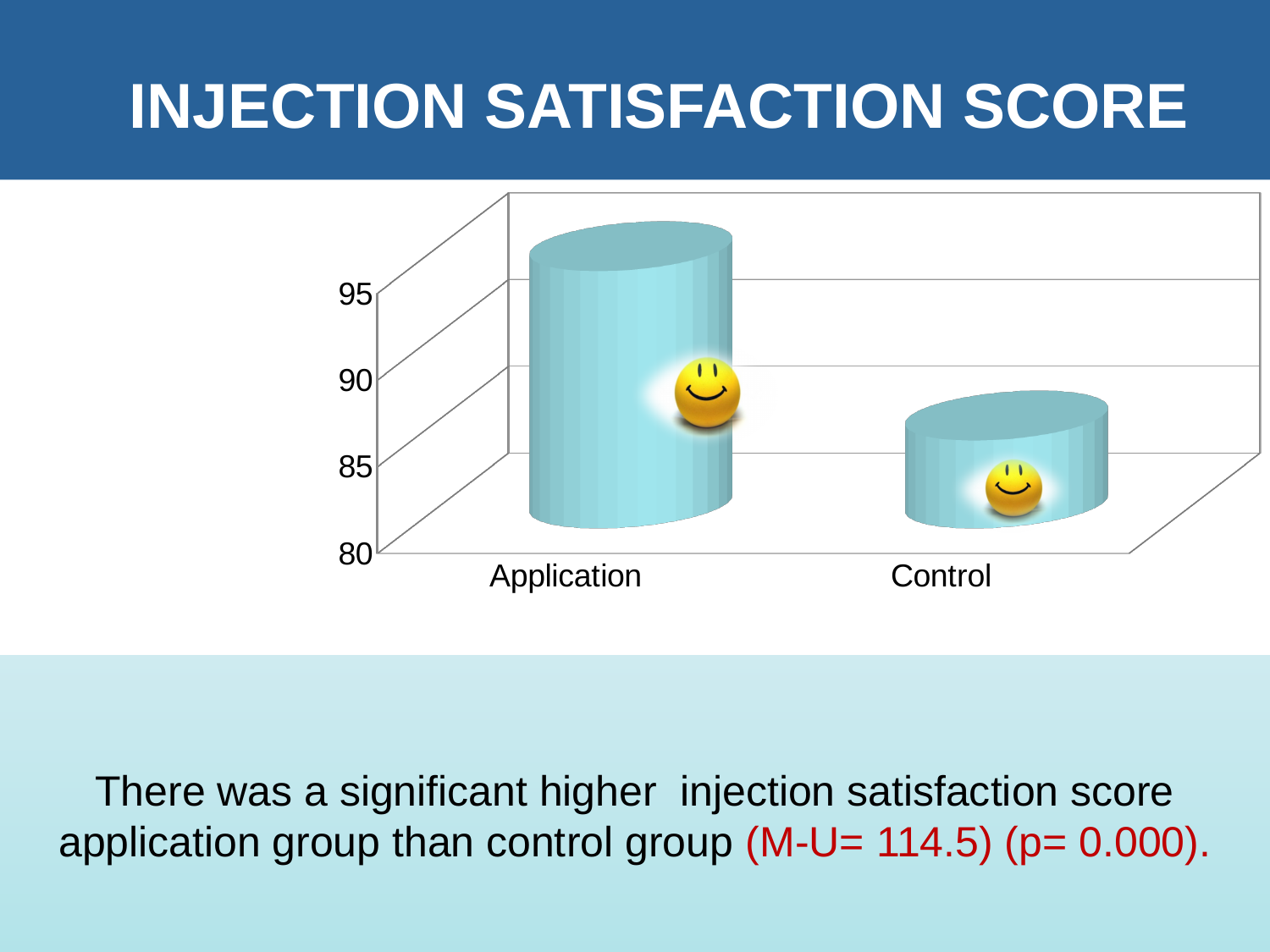
Is the value for Application greater or less than 90? greater Is the value for Control greater or less than 90? less What kind of chart is shown on the slide? bar chart Which category has the highest injection satisfaction score? Application Which is larger, the value for Application or the value for Control? Application What is the title of the slide containing the chart? INJECTION SATISFACTION SCORE Which category has the lowest injection satisfaction score? Control What is the lowest value shown on the vertical axis of the chart? 80 How many categories are plotted on the chart? 2 Is the value for Control greater or less than 80? greater